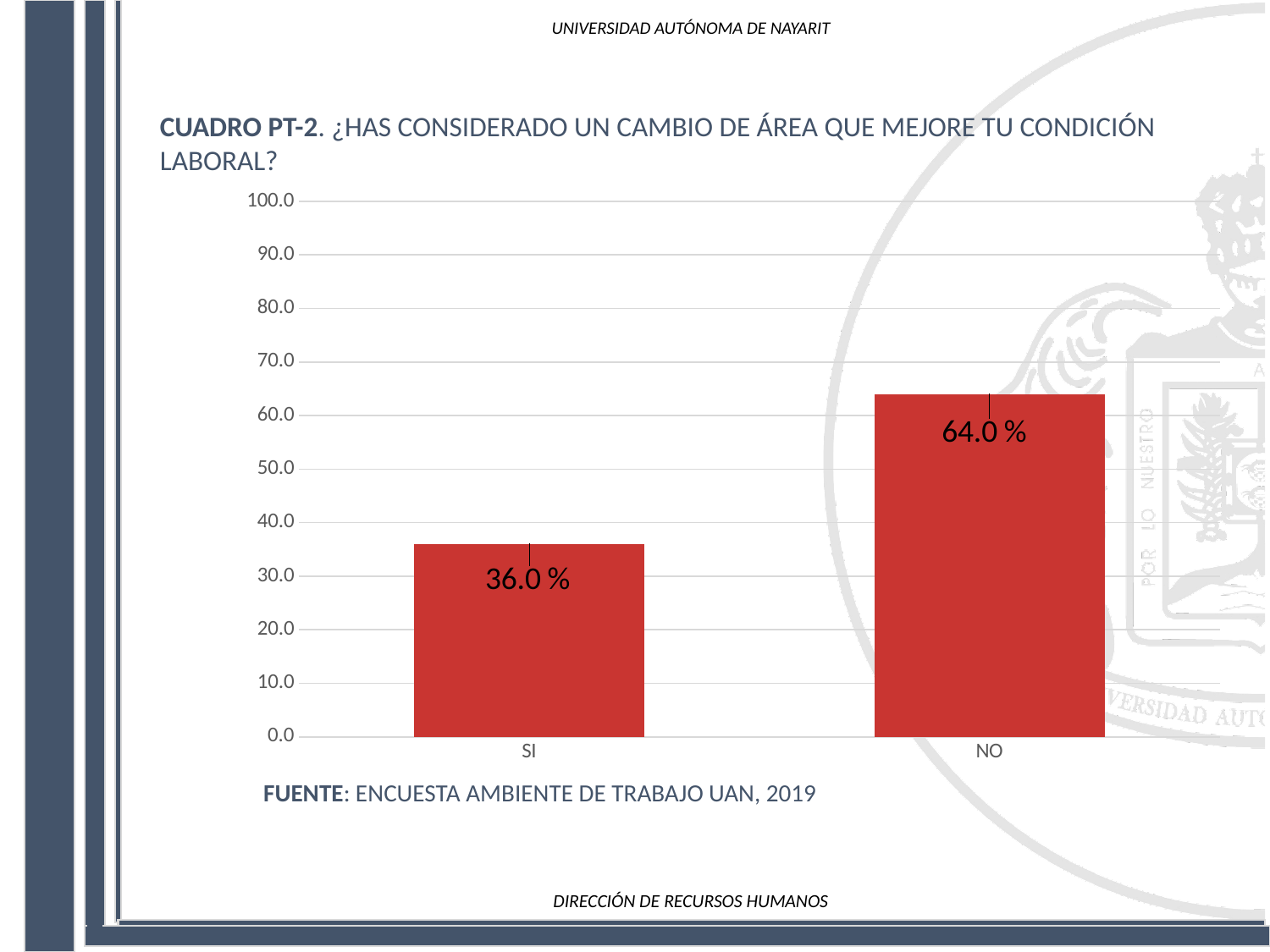
What is the difference between the values for NO and SI? 28.0 % Which category has the lowest value? SI What kind of chart is shown on the slide? bar chart Which is larger, the value for SI or the value for NO? NO How many categories are shown on the x axis? 2 Which category has the highest value? NO Is the value for NO greater or less than 60.0? greater What is the highest value shown on the y axis? 100.0 Is the value for SI greater or less than 40.0? less What is the value for NO? 64.0 % What is the value for SI? 36.0 % What is the source cited below the chart? ENCUESTA AMBIENTE DE TRABAJO UAN, 2019